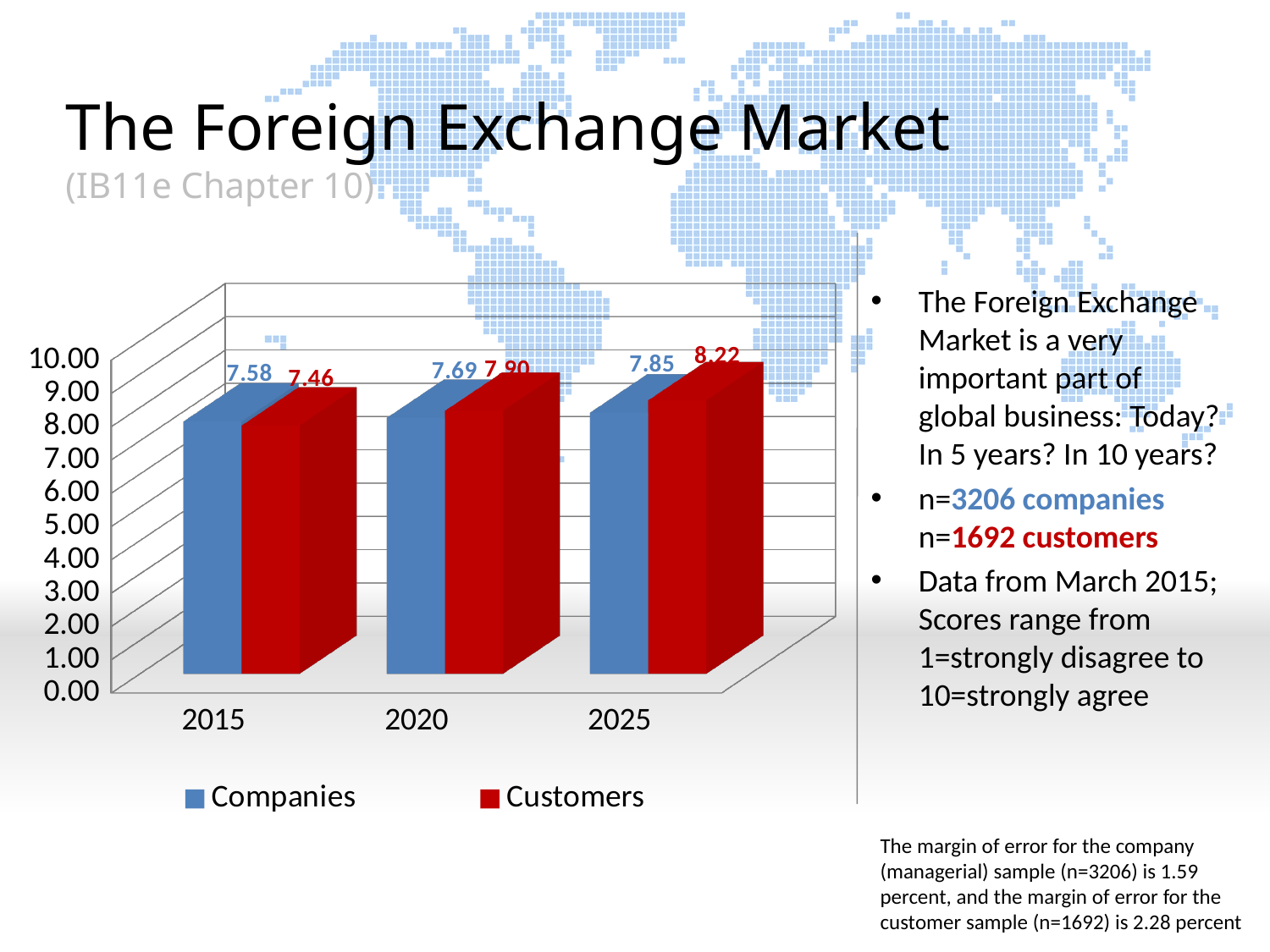
What is the value for Companies in 2015? 7.58 How many years are shown on the x axis? 3 What is the difference between the Customers and Companies values in 2025? 0.37 Do the Customers values rise or fall from 2015 to 2025? Rise What is the value for Companies in 2025? 7.85 What is the value for Customers in 2025? 8.22 In which year is the Companies value lowest? 2015 What is the value for Customers in 2020? 7.90 How many series does the legend list? 2 In 2015, which is larger: the Companies value or the Customers value? Companies In which year is the Customers value highest? 2025 What kind of chart is shown on the slide? Bar chart